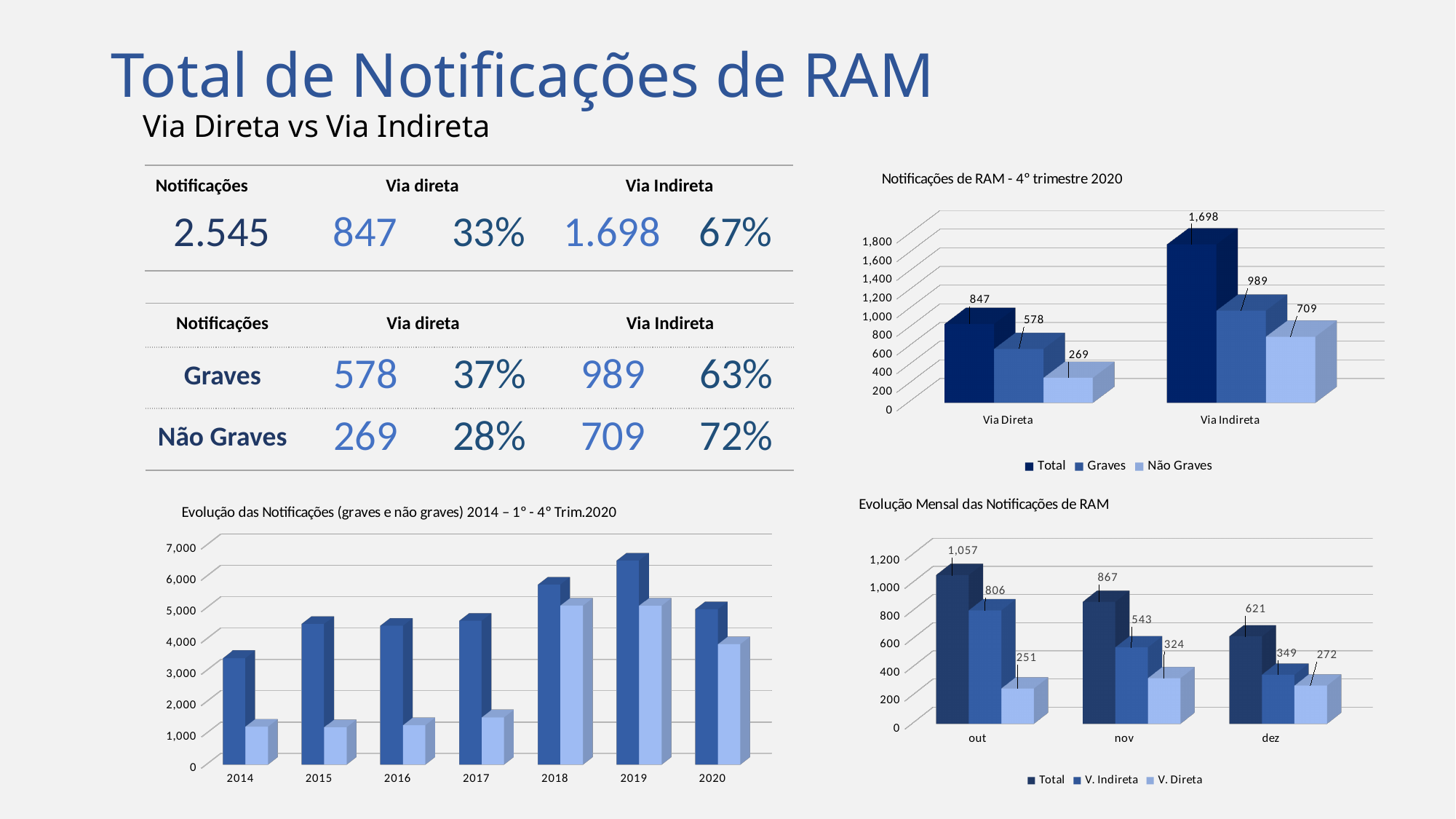
In the chart titled 'Evolução Mensal das Notificações de RAM', is the V. Indireta value for out or for dez larger? out What kind of chart is the chart titled 'Evolução das Notificações (graves e não graves) 2014 – 1° - 4° Trim.2020'? bar chart In the chart titled 'Notificações de RAM - 4° trimestre 2020', what is the difference between the Não Graves values for Via Indireta and Via Direta? 440 How many years are shown on the x axis of the chart titled 'Evolução das Notificações (graves e não graves) 2014 – 1° - 4° Trim.2020'? 7 In the chart titled 'Evolução Mensal das Notificações de RAM', what is the Total value for nov? 867 How many series does the legend of the chart titled 'Notificações de RAM - 4° trimestre 2020' list? 3 In the chart titled 'Evolução das Notificações (graves e não graves) 2014 – 1° - 4° Trim.2020', is the value of the taller (dark blue) bar for 2019 greater or less than 6,000? greater In the chart titled 'Notificações de RAM - 4° trimestre 2020', what is the Total value for Via Indireta? 1,698 In the chart titled 'Evolução Mensal das Notificações de RAM', which month has the lowest Total value? dez In the chart titled 'Evolução Mensal das Notificações de RAM', does the Total value rise or fall from out to dez? fall In the chart titled 'Evolução Mensal das Notificações de RAM', what is the V. Direta value for out? 251 In the chart titled 'Notificações de RAM - 4° trimestre 2020', what is the Graves value for Via Direta? 578